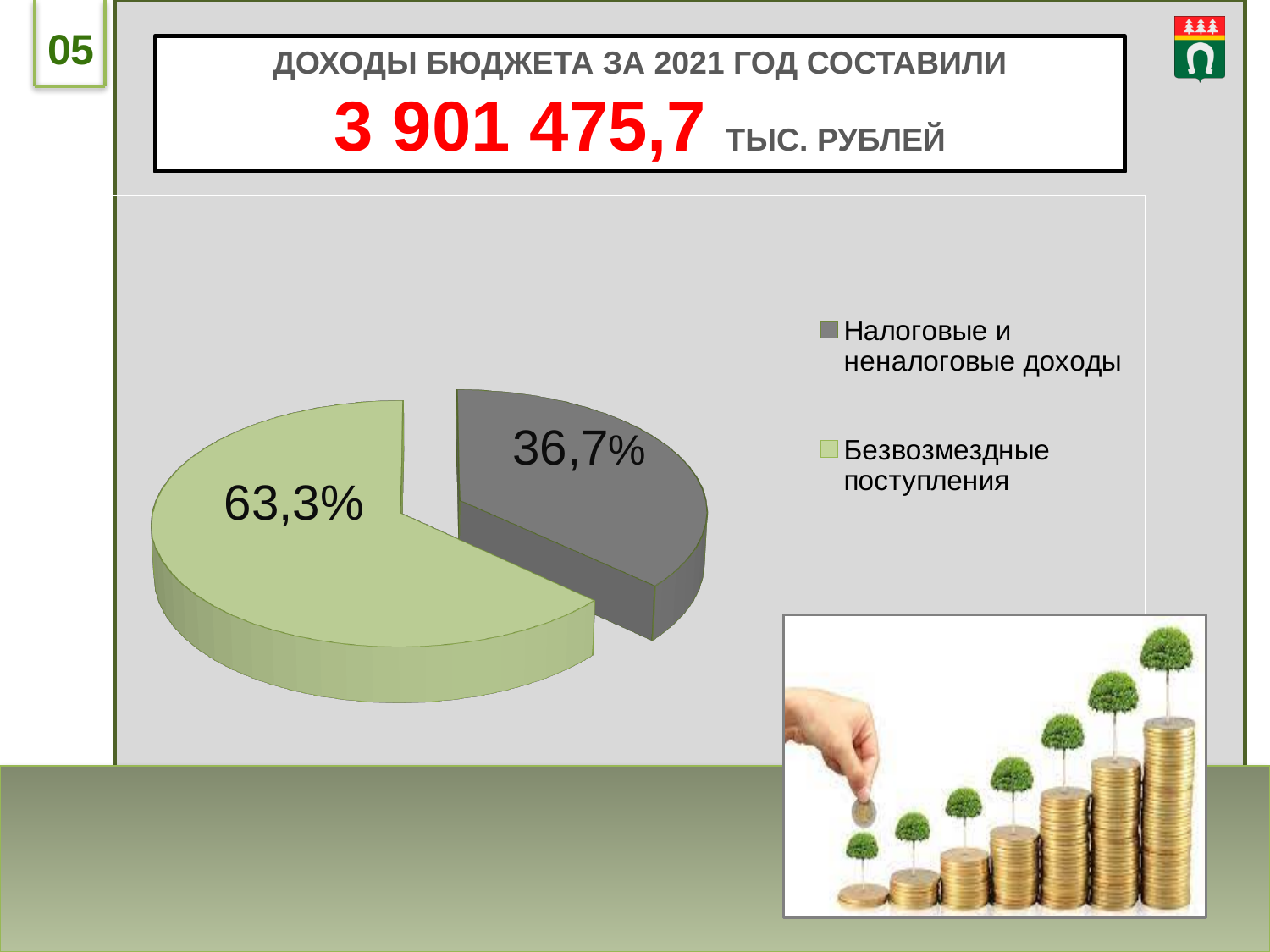
What colour is the slice for "Безвозмездные поступления"? light green What total budget revenue for 2021 is stated in the slide title? 3 901 475,7 тыс. рублей Which category has the smallest slice of the pie? Налоговые и неналоговые доходы How many slices does the pie chart have? 2 Which category has the largest slice of the pie? Безвозмездные поступления What kind of chart is shown on the slide? pie chart What share of the pie does "Налоговые и неналоговые доходы" have? 36,7% What colour is the slice for "Налоговые и неналоговые доходы"? grey Which is larger: the share for "Налоговые и неналоговые доходы" or the share for "Безвозмездные поступления"? Безвозмездные поступления What share of the pie does "Безвозмездные поступления" have? 63,3% What is the difference in percentage points between the "Безвозмездные поступления" slice and the "Налоговые и неналоговые доходы" slice? 26,6 How many entries does the legend list? 2